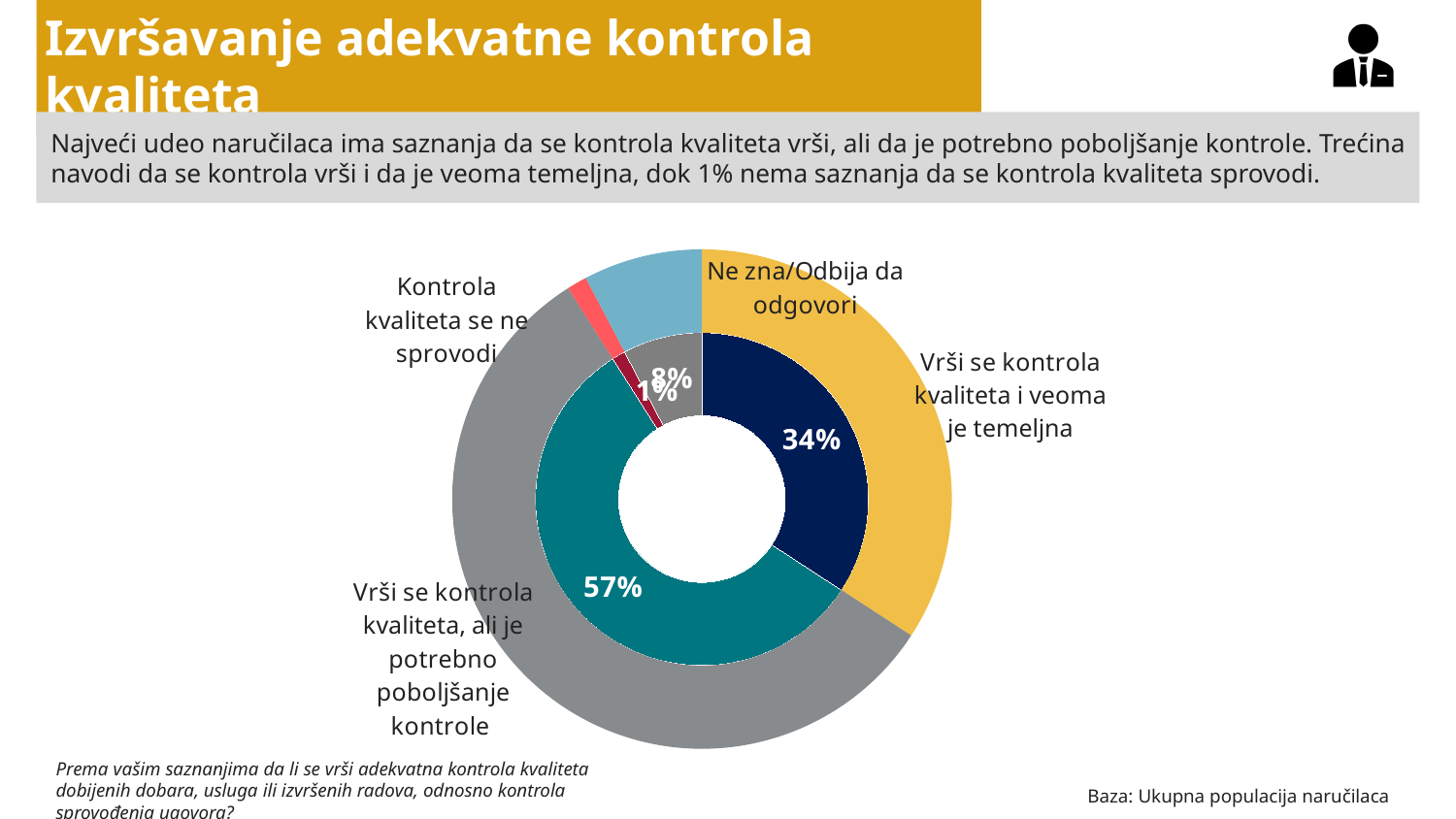
Which category has the smallest share in the chart? Kontrola kvaliteta se ne sprovodi What is the difference in percentage points between 'Vrši se kontrola kvaliteta, ali je potrebno poboljšanje kontrole' and 'Vrši se kontrola kvaliteta i veoma je temeljna'? 23 percentage points What percentage of respondents say quality control is performed and is very thorough (Vrši se kontrola kvaliteta i veoma je temeljna)? 34% What percentage of respondents say quality control is not carried out (Kontrola kvaliteta se ne sprovodi)? 1% What is the base (Baza) stated for the chart? Ukupna populacija naručilaca Which is larger: the share for 'Vrši se kontrola kvaliteta i veoma je temeljna' or for 'Ne zna/Odbija da odgovori'? Vrši se kontrola kvaliteta i veoma je temeljna What kind of chart is shown on the slide? Doughnut (pie) chart What colour is the segment for 'Vrši se kontrola kvaliteta, ali je potrebno poboljšanje kontrole' in the inner ring? Teal Which category has the largest share in the chart? Vrši se kontrola kvaliteta, ali je potrebno poboljšanje kontrole How many categories are shown in the chart? 4 What percentage of respondents say quality control is performed but improvement is needed (Vrši se kontrola kvaliteta, ali je potrebno poboljšanje kontrole)? 57% What percentage of respondents answered 'Ne zna/Odbija da odgovori'? 8%